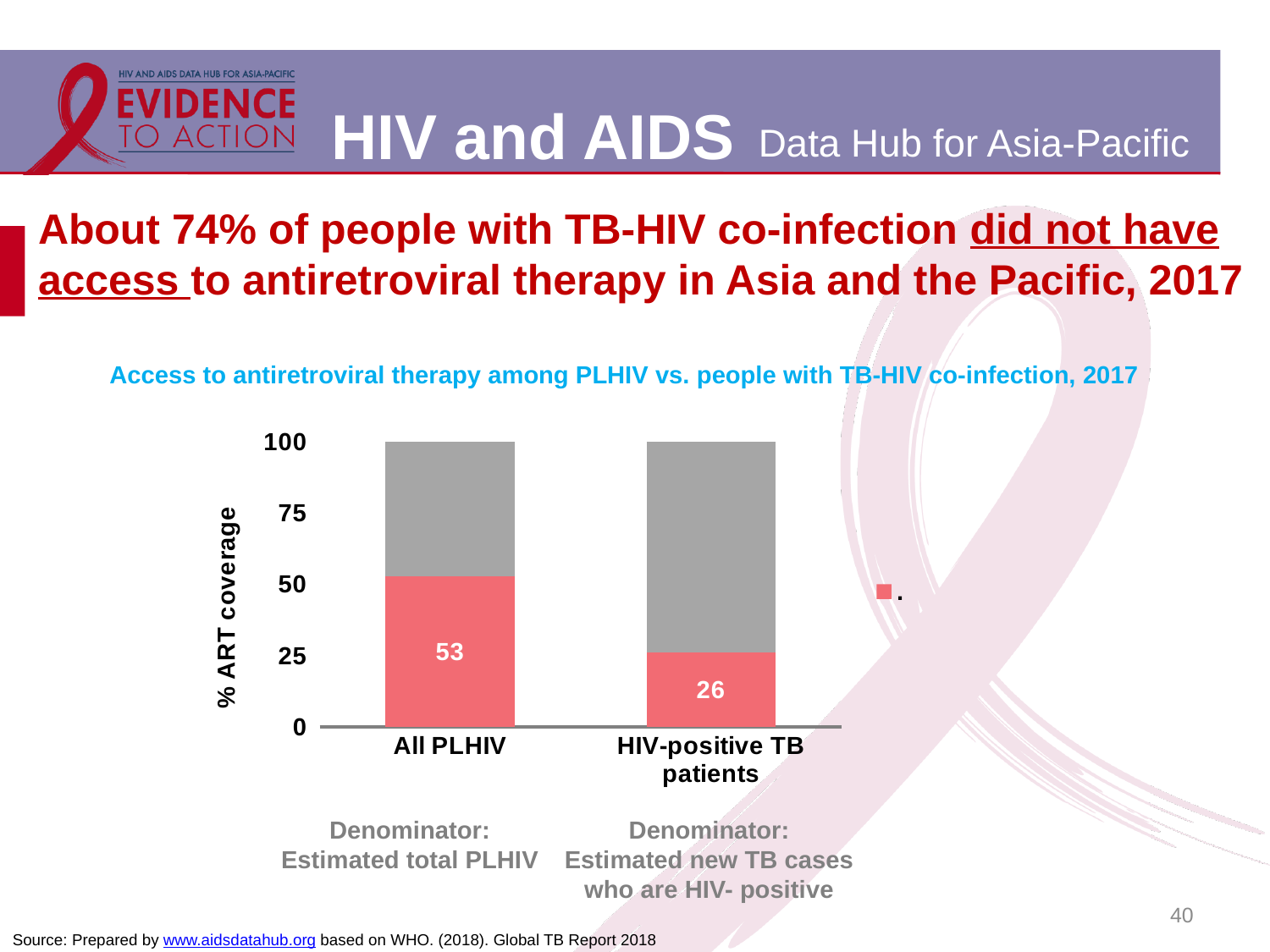
What is the ART coverage value shown for HIV-positive TB patients? 26 Is the ART coverage value for HIV-positive TB patients greater or less than 50? less Is the ART coverage value for All PLHIV larger or smaller than the value for HIV-positive TB patients? larger Is the ART coverage value for All PLHIV greater or less than 50? greater What is the label on the y axis of the chart? % ART coverage What is the difference between the ART coverage values for All PLHIV and HIV-positive TB patients? 27 Do the labelled ART coverage values rise or fall from All PLHIV to HIV-positive TB patients? fall What is the ART coverage value shown for All PLHIV? 53 How many categories are shown on the x axis of the chart? 2 Which category has the higher ART coverage value? All PLHIV Which category has the lower ART coverage value? HIV-positive TB patients What kind of chart is shown on the slide? bar chart